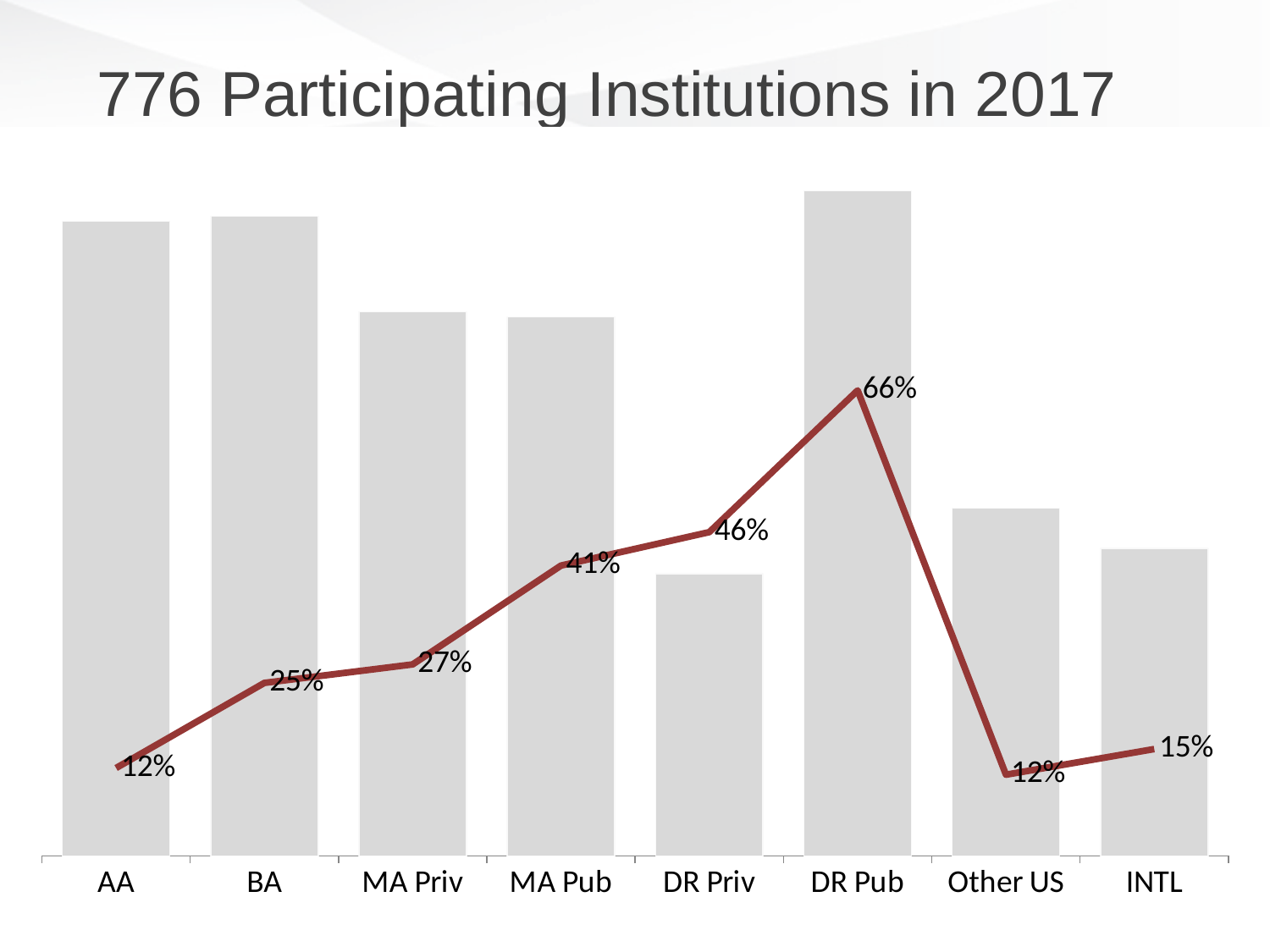
Which category has the highest percentage on the line? DR Pub What is the difference between the line percentages for DR Pub and DR Priv? 20 percentage points What is the title of the slide? 776 Participating Institutions in 2017 How many categories are shown on the x axis? 8 What is the percentage shown on the line for INTL? 15% Which category has the tallest bar? DR Pub What is the percentage shown on the line for MA Pub? 41% What is the percentage shown on the line for DR Pub? 66% Which has the taller bar, Other US or INTL? Other US What is the percentage shown on the line for BA? 25% Does the line rise or fall from AA to DR Pub? rise Which category has the shortest bar? DR Priv